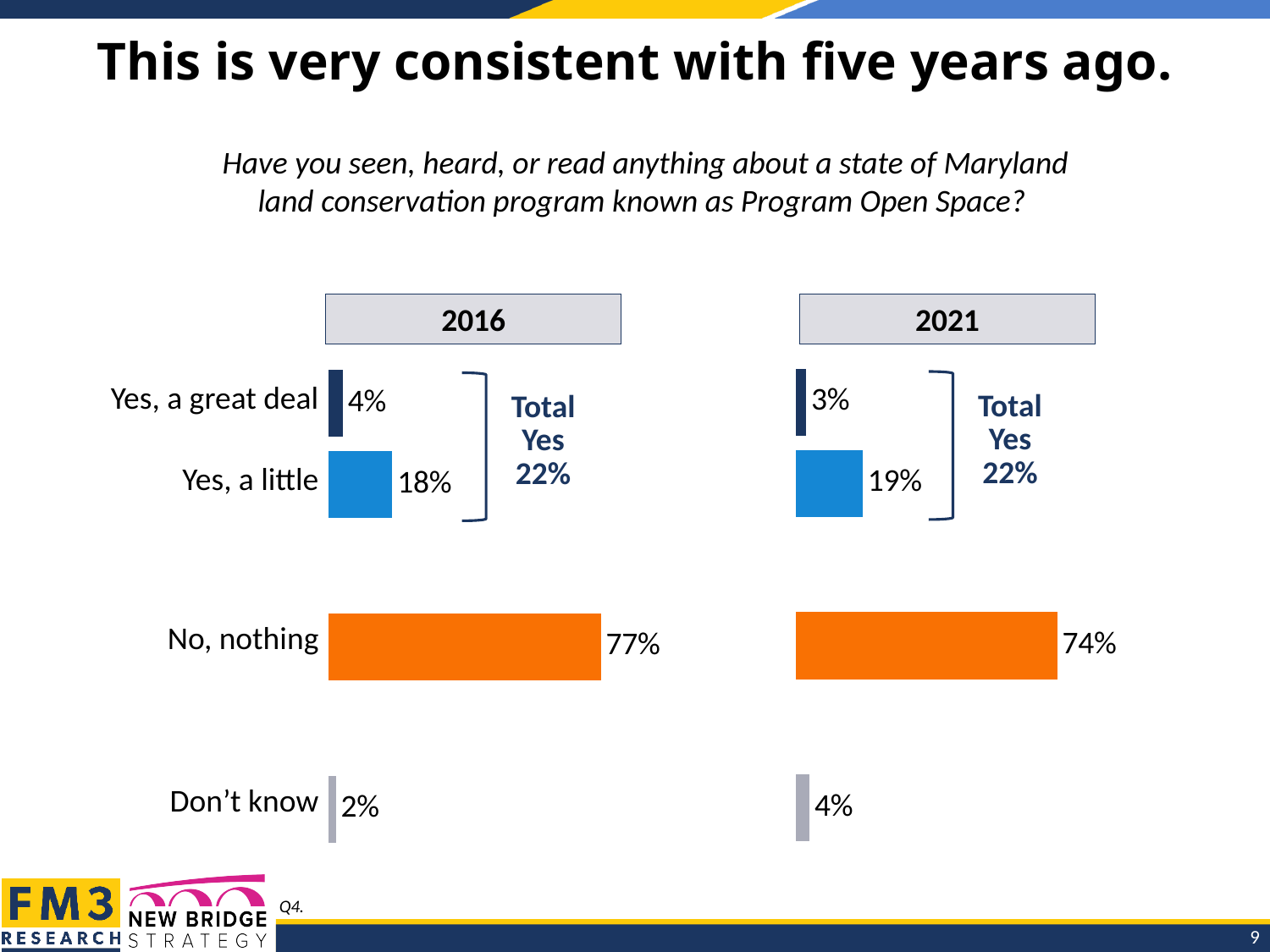
In the 2021 chart, what percentage answered "Yes, a great deal"? 3% Is the "Don't know" percentage larger in the 2016 chart or the 2021 chart? 2021 In the 2021 chart, what percentage answered "Yes, a little"? 19% In the 2016 chart, what percentage answered "Don't know"? 2% In the 2021 chart, which response has the lowest percentage? Yes, a great deal What is the "Total Yes" figure shown for the 2021 chart? 22% What colour is the "No, nothing" bar in the 2016 chart? Orange What is the difference between the "No, nothing" percentages in the 2016 and 2021 charts? 3 percentage points In the 2016 chart, which response has the highest percentage? No, nothing In the 2016 chart, what percentage answered "No, nothing"? 77% What type of chart is used to show the 2021 results? Bar chart How many response categories are shown in the 2016 chart? 4